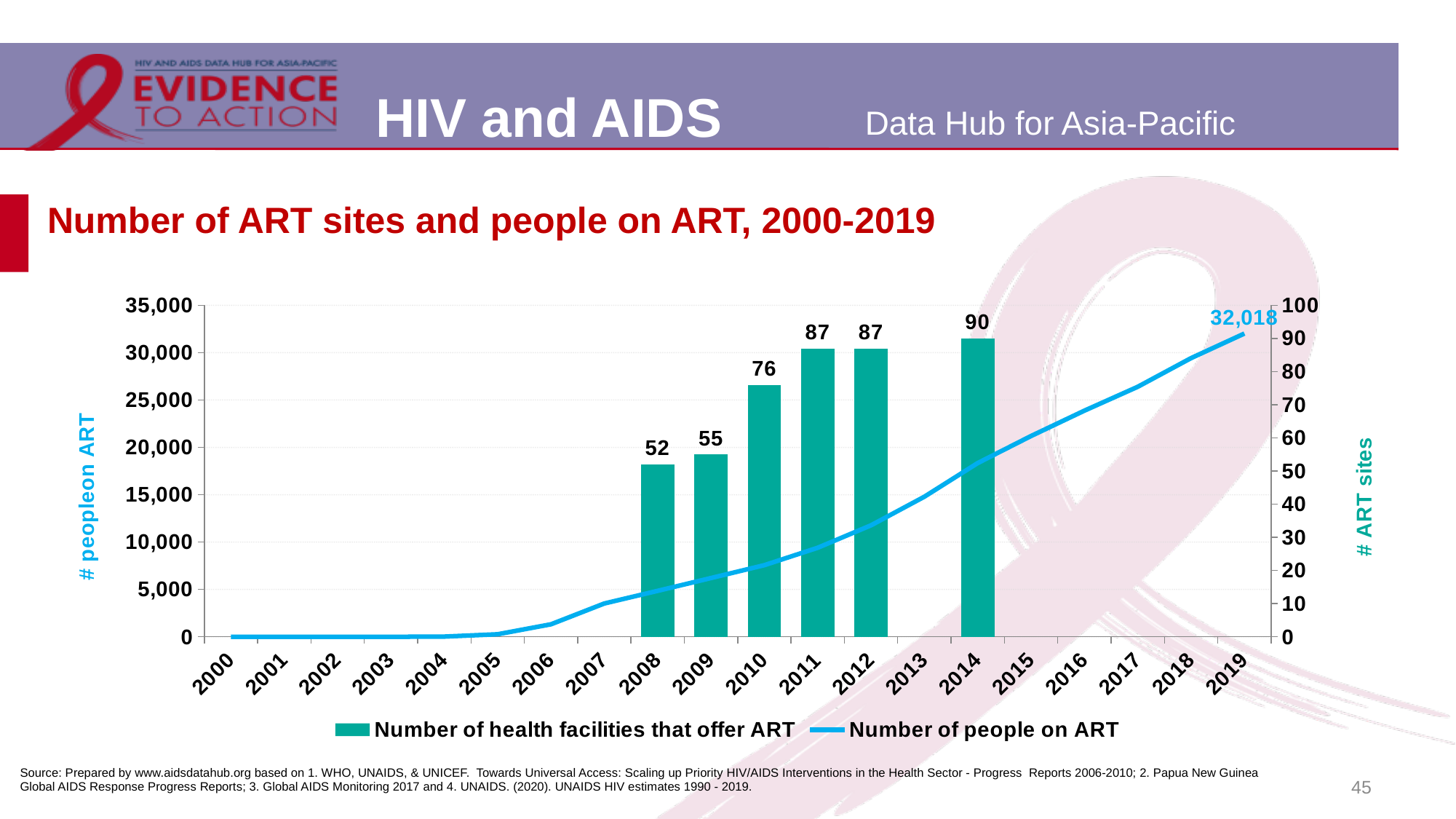
What is the number of health facilities that offer ART in 2010? 76 Which year has the lowest number of health facilities that offer ART among the years with bars? 2008 What is the number of health facilities that offer ART in 2008? 52 How many years have a bar for the number of health facilities that offer ART? 6 Which is larger, the number of health facilities that offer ART in 2009 or in 2010? 2010 How many series does the legend list? 2 Is the number of people on ART in 2010 greater or less than 10,000? less Is the number of people on ART in 2015 greater or less than 15,000? greater What is the number of people on ART in 2019? 32,018 Which year has the highest number of health facilities that offer ART? 2014 Does the number of people on ART rise or fall from 2000 to 2019? rise What is the difference between the number of health facilities that offer ART in 2014 and in 2008? 38